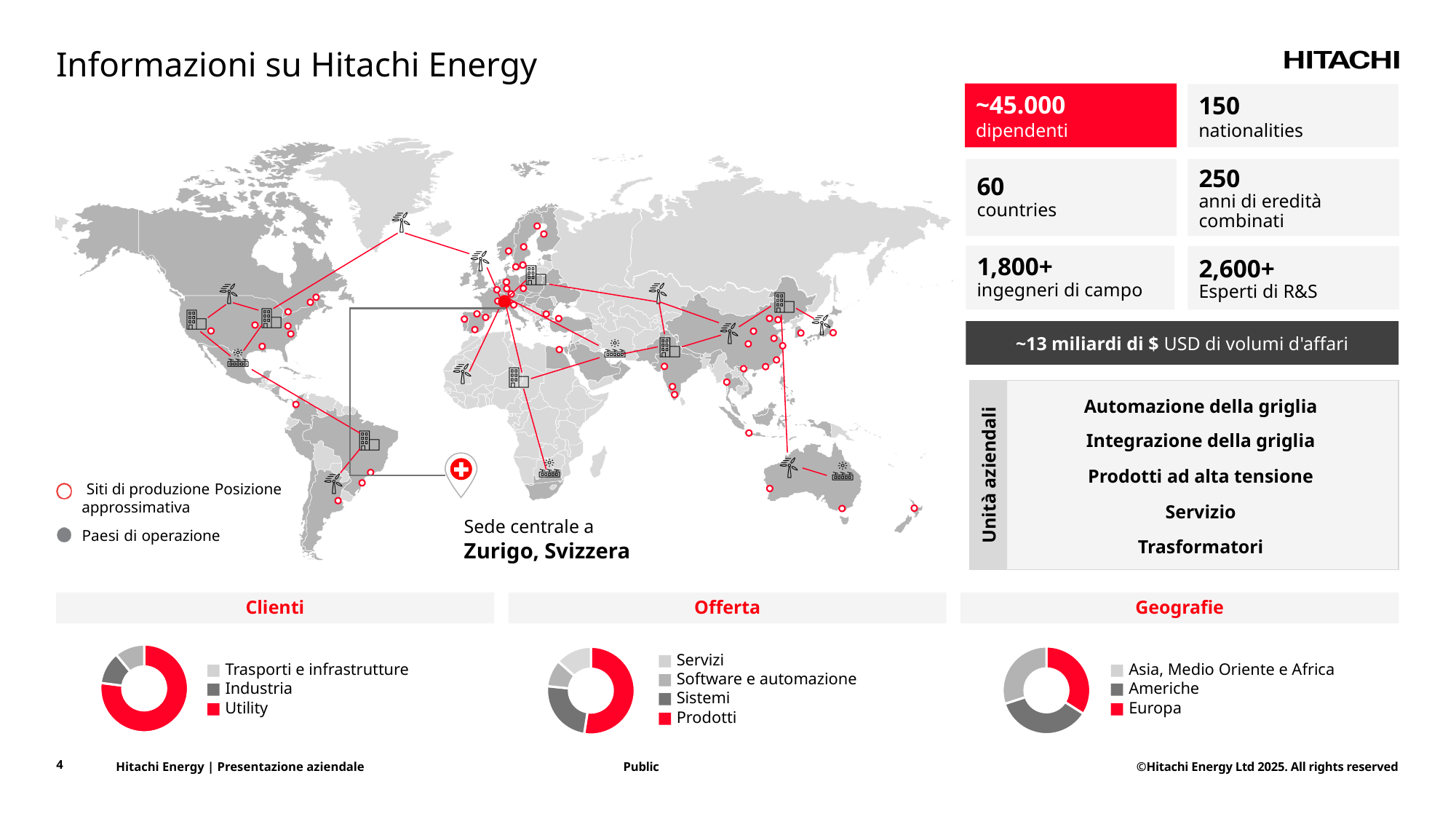
In the 'Offerta' chart, which colour represents Prodotti? Red How many categories does the legend of the 'Geografie' chart list? 3 In the 'Geografie' chart, which category has the smallest share? Asia, Medio Oriente e Africa How many categories does the legend of the 'Clienti' chart list? 3 In the 'Clienti' chart, which is larger: Utility or Industria? Utility In the 'Offerta' chart, which is larger: Sistemi or Servizi? Sistemi How many categories does the legend of the 'Offerta' chart list? 4 In the 'Geografie' chart, which is larger: Europa or Asia, Medio Oriente e Africa? Europa What kind of chart is shown under the 'Clienti' heading? Pie chart (donut) In the 'Offerta' chart, which category has the largest share? Prodotti In the 'Clienti' chart, which category has the largest share? Utility What kind of chart is shown under the 'Geografie' heading? Pie chart (donut)